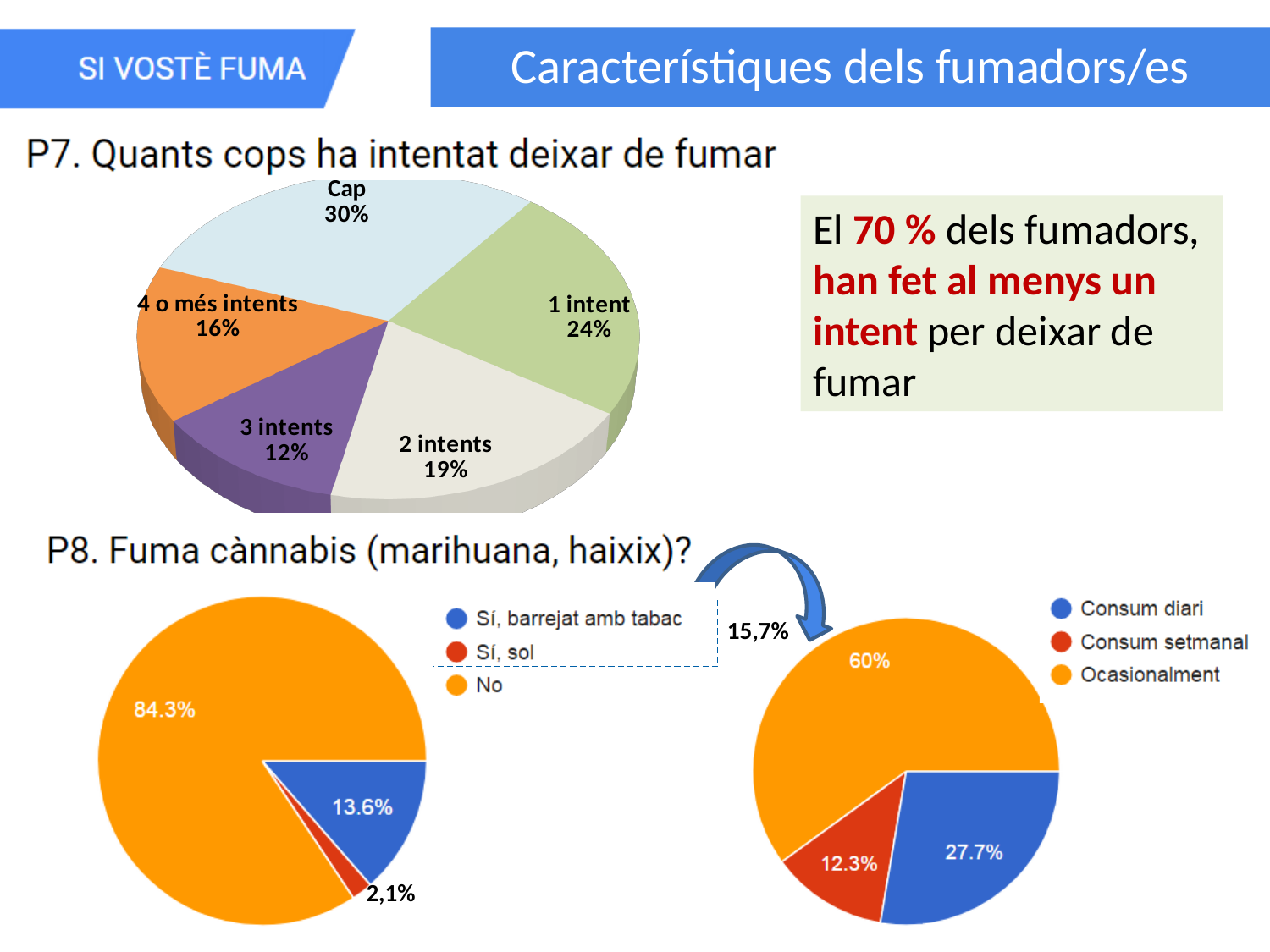
In the left P8 chart 'Fuma cànnabis', what percentage answered 'No'? 84.3% How many entries does the legend of the left P8 chart 'Fuma cànnabis' list? 3 In the P7 chart 'Quants cops ha intentat deixar de fumar', which category has the smallest slice? 3 intents In the right P8 chart (consumption frequency), which category has the largest slice? Ocasionalment In the P7 chart 'Quants cops ha intentat deixar de fumar', how many categories are shown? 5 What kind of chart is used for P7 'Quants cops ha intentat deixar de fumar'? Pie chart In the P7 chart 'Quants cops ha intentat deixar de fumar', what is the difference between '1 intent' and '2 intents'? 5% In the P7 chart 'Quants cops ha intentat deixar de fumar', which category has the largest slice? Cap In the P7 chart 'Quants cops ha intentat deixar de fumar', which is larger: '4 o més intents' or '3 intents'? 4 o més intents In the left P8 chart 'Fuma cànnabis', what percentage answered 'Sí, sol'? 2,1% In the P7 chart 'Quants cops ha intentat deixar de fumar', what percentage corresponds to 'Cap'? 30% In the right P8 chart (consumption frequency), what percentage corresponds to 'Consum diari'? 27.7%